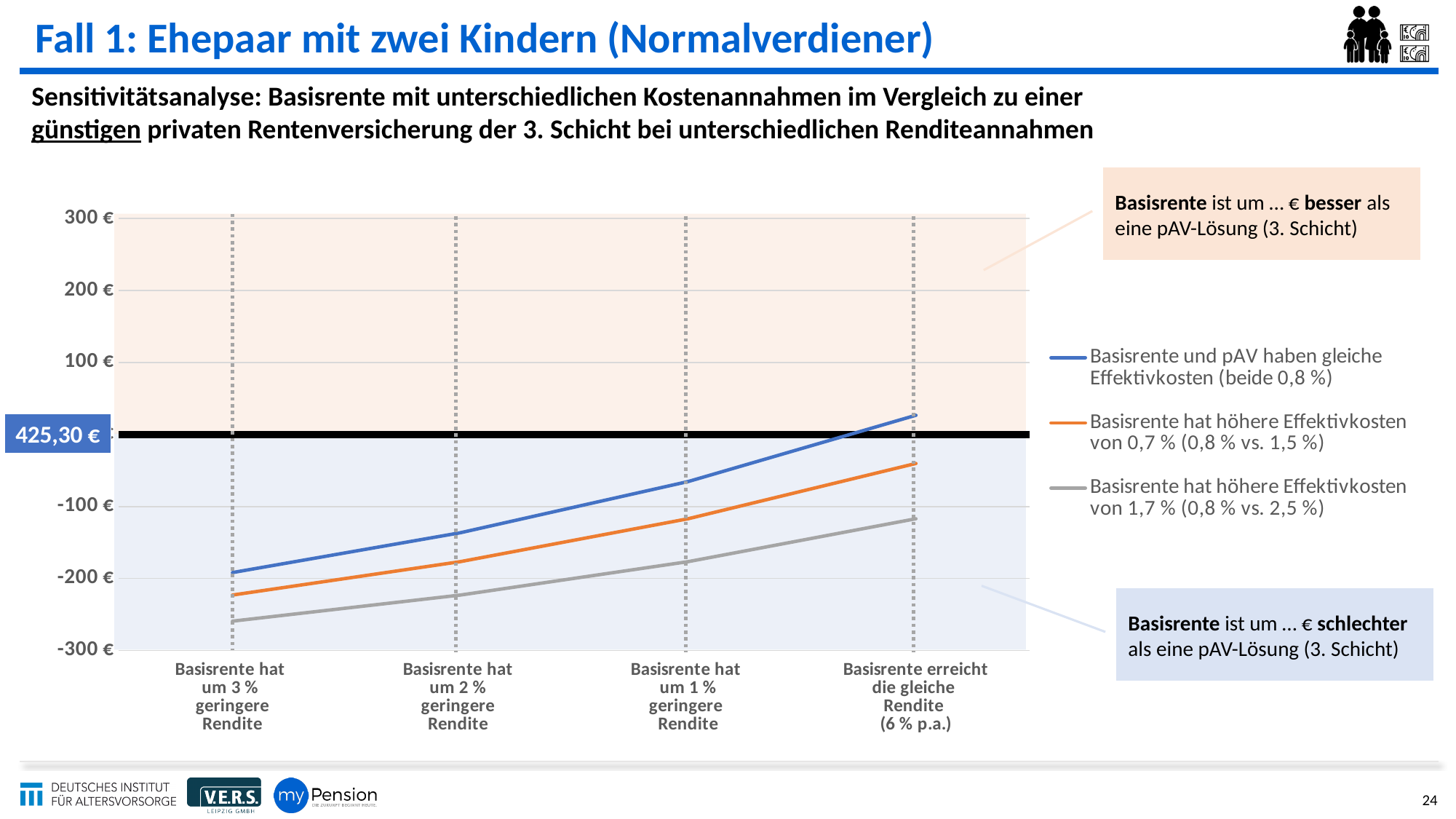
Which colour is used for the series 'Basisrente hat höhere Effektivkosten von 0,7 % (0,8 % vs. 1,5 %)'? orange How many series does the legend list? 3 Is the value of the series 'Basisrente und pAV haben gleiche Effektivkosten (beide 0,8 %)' at 'Basisrente hat um 3 % geringere Rendite' greater or less than -100 €? less What kind of chart is shown on the slide? line chart What value is printed on the label of the horizontal black reference line? 425,30 € Is the value of the series 'Basisrente hat höhere Effektivkosten von 0,7 % (0,8 % vs. 1,5 %)' at 'Basisrente erreicht die gleiche Rendite (6 % p.a.)' greater or less than -100 €? greater How many categories are shown along the x axis? 4 Which series has the highest value at 'Basisrente erreicht die gleiche Rendite (6 % p.a.)'? Basisrente und pAV haben gleiche Effektivkosten (beide 0,8 %) At 'Basisrente hat um 1 % geringere Rendite', which series has the larger value: the blue series or the grey series? the blue series (Basisrente und pAV haben gleiche Effektivkosten) Is the value of the series 'Basisrente hat höhere Effektivkosten von 1,7 % (0,8 % vs. 2,5 %)' at 'Basisrente hat um 3 % geringere Rendite' greater or less than -200 €? less Which series has the lowest value at 'Basisrente hat um 3 % geringere Rendite'? Basisrente hat höhere Effektivkosten von 1,7 % (0,8 % vs. 2,5 %) Do the values of the series rise or fall from left to right along the x axis? rise